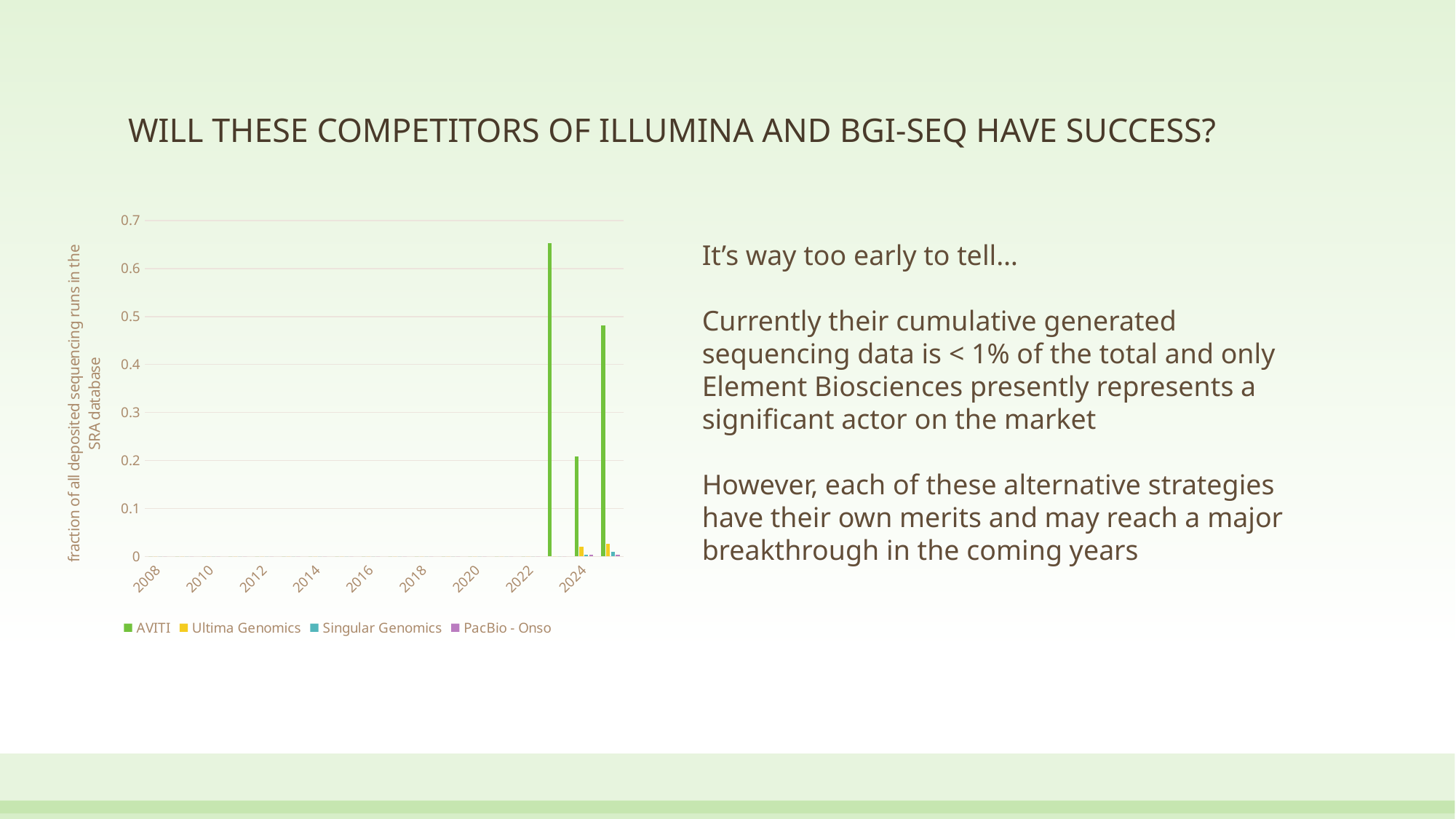
In 2024, which series has the taller bar, AVITI or Ultima Genomics? AVITI How many year labels are shown on the x axis of the chart? 9 What is the label of the y axis of the chart? fraction of all deposited sequencing runs in the SRA database Which series has the tallest bar in the chart? AVITI Is the AVITI bar at 2024 greater or less than 0.3? less How many series does the chart legend list? 4 Is the Ultima Genomics bar at 2024 greater or less than 0.1? less What kind of chart is shown on the slide? bar chart Is the tallest AVITI bar greater or less than 0.6? greater Which series is shown in green in the chart legend? AVITI What is the highest value shown on the y axis of the chart? 0.7 What is the first year label on the x axis of the chart? 2008